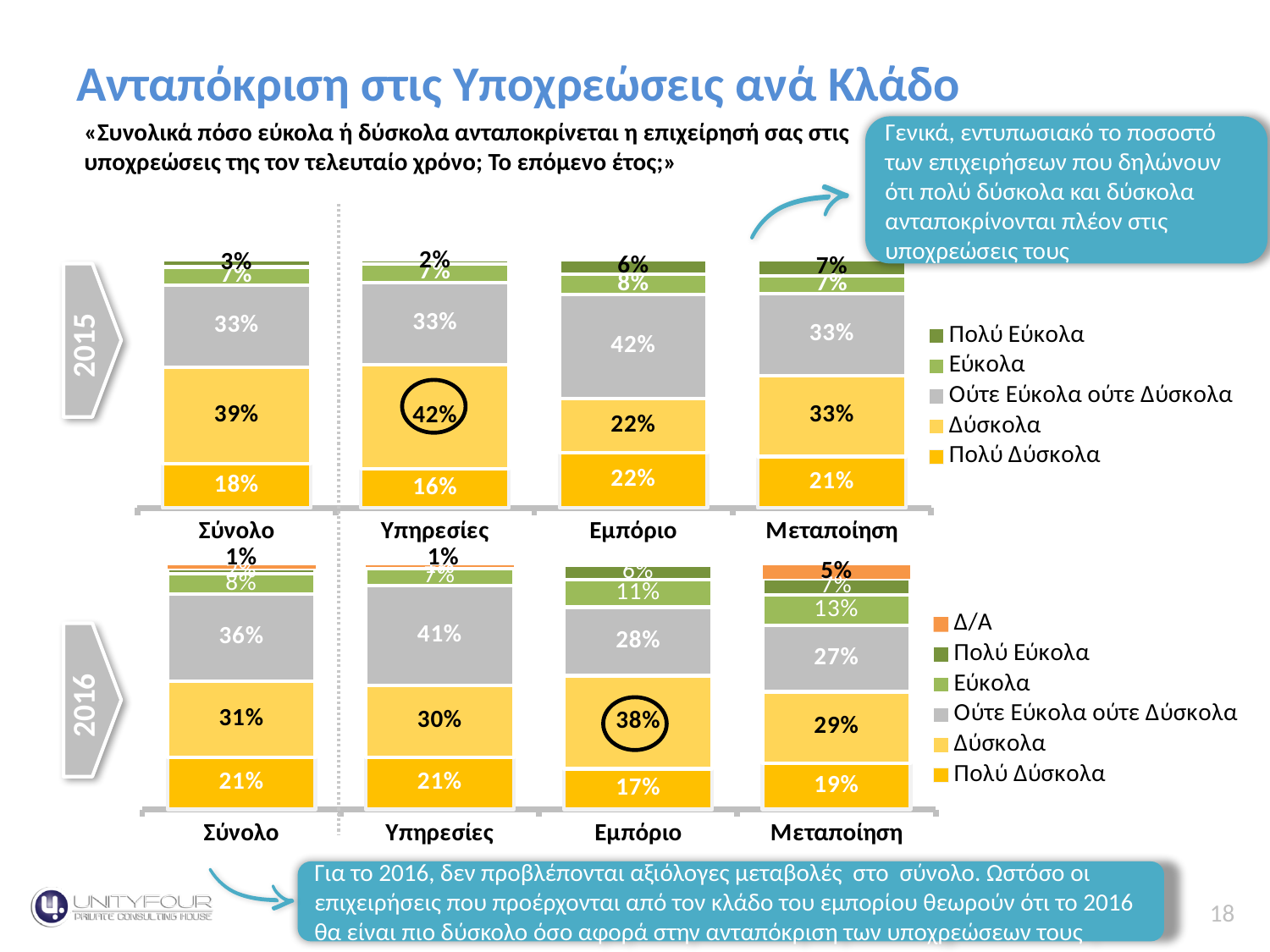
In the 2016 chart, which category has the lowest Πολύ Δύσκολα value? Εμπόριο In the 2015 chart, what is the combined value of Πολύ Δύσκολα and Δύσκολα for Σύνολο? 57% How many series does the legend of the 2016 chart list? 6 What type of chart is the 2015 chart? Stacked bar chart How many categories are shown on the x axis of the 2016 chart? 4 In the 2015 chart, what is the value of Δύσκολα for Υπηρεσίες? 42% In the 2015 chart, what is the value of Ούτε Εύκολα ούτε Δύσκολα for Εμπόριο? 42% In the 2016 chart, what is the value of Δ/Α for Μεταποίηση? 5% In the 2015 chart, which category has the highest Πολύ Δύσκολα value? Εμπόριο In the 2016 chart, what is the value of Δύσκολα for Εμπόριο? 38% In the 2016 chart, which is larger: Ούτε Εύκολα ούτε Δύσκολα for Υπηρεσίες or for Μεταποίηση? Υπηρεσίες In the 2015 chart, what is the difference between the Δύσκολα values for Υπηρεσίες and Εμπόριο? 20%